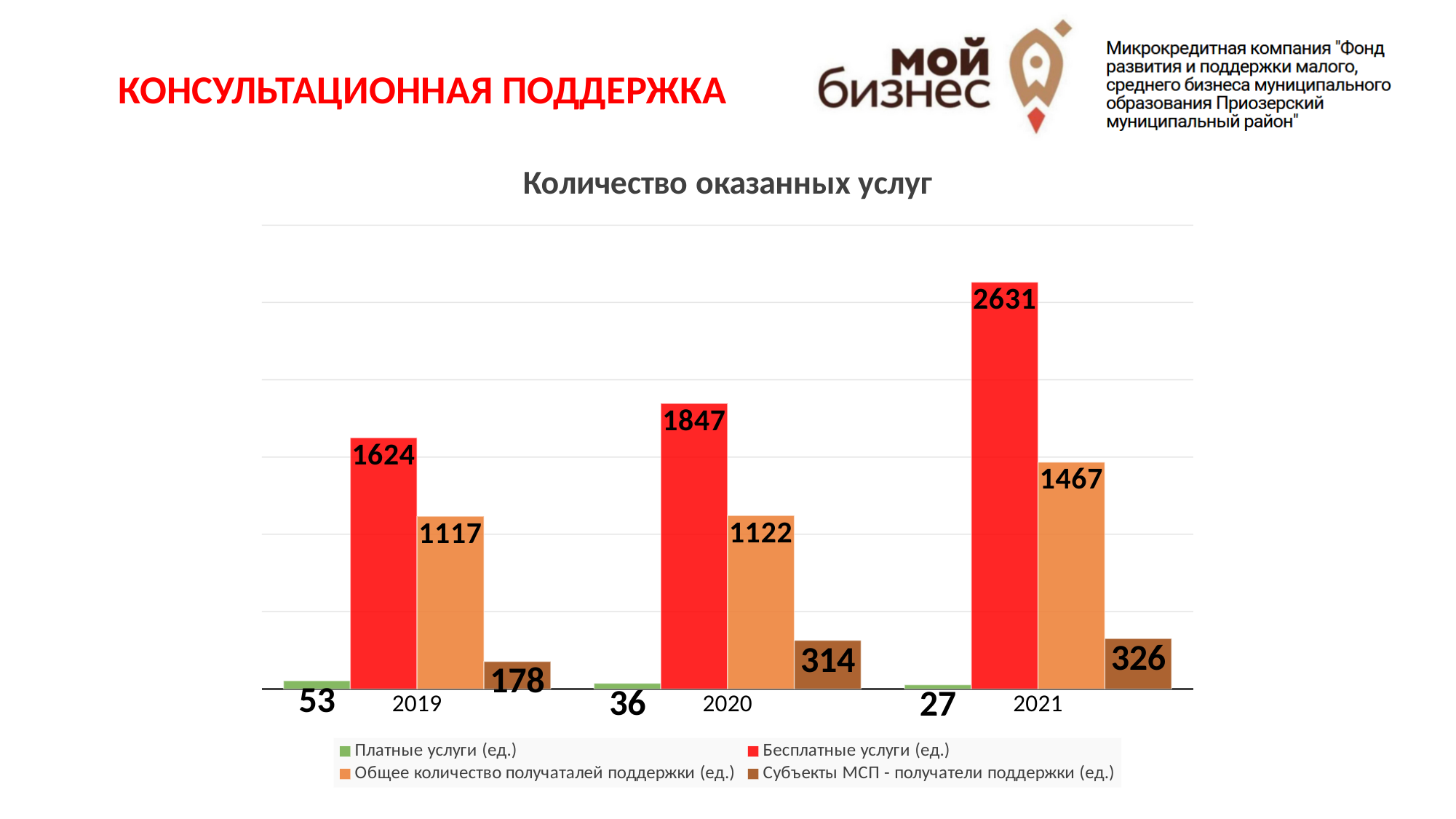
What type of chart is shown on the slide? Bar chart Does Платные услуги (ед.) rise or fall from 2019 to 2021? Fall How many years (categories) are shown on the x axis? 3 What is the value of Общее количество получаталей поддержки (ед.) in 2020? 1122 What is the value of Платные услуги (ед.) in 2019? 53 What is the title of the chart? Количество оказанных услуг How many series does the legend list? 4 What is the difference between Бесплатные услуги (ед.) in 2021 and in 2020? 784 In which year is Бесплатные услуги (ед.) the highest? 2021 What is the value of Бесплатные услуги (ед.) in 2021? 2631 What is the value of Субъекты МСП - получатели поддержки (ед.) in 2021? 326 In which year is Платные услуги (ед.) the lowest? 2021